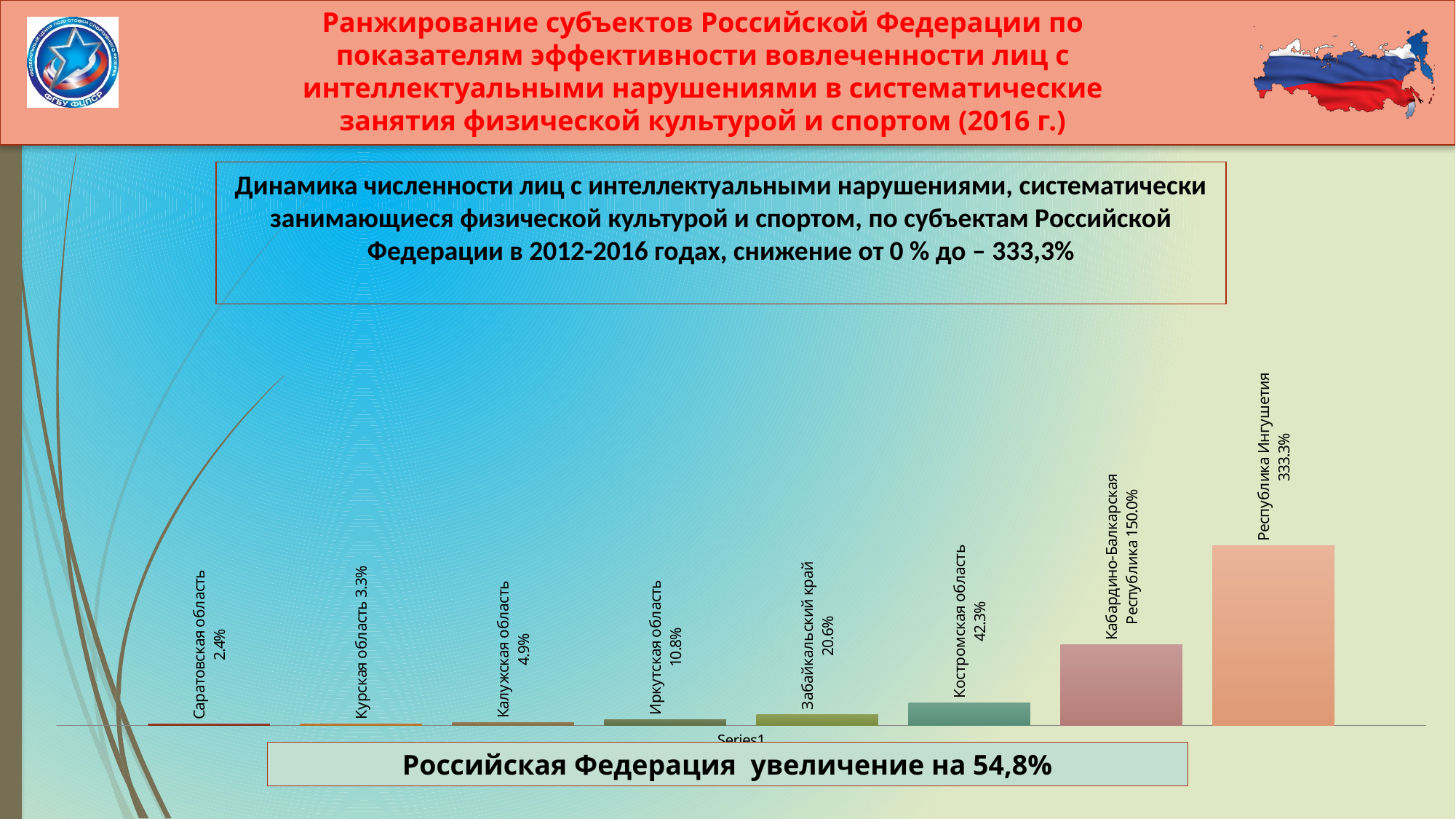
What value is shown for Забайкальский край? 20.6% What kind of chart is shown on the slide? Bar chart What value is shown for Республика Ингушетия? 333.3% Which region has the lowest value in the chart? Саратовская область Which region has the highest value in the chart? Республика Ингушетия What value is shown for Кабардино-Балкарская Республика? 150.0% Do the values rise or fall from left to right along the x axis? Rise What is the difference between the values for Республика Ингушетия and Кабардино-Балкарская Республика? 183.3% What value is shown for Иркутская область? 10.8% What value is shown for Костромская область? 42.3% Which is larger, the value for Костромская область or the value for Забайкальский край? Костромская область How many regions (bars) are shown in the chart? 8